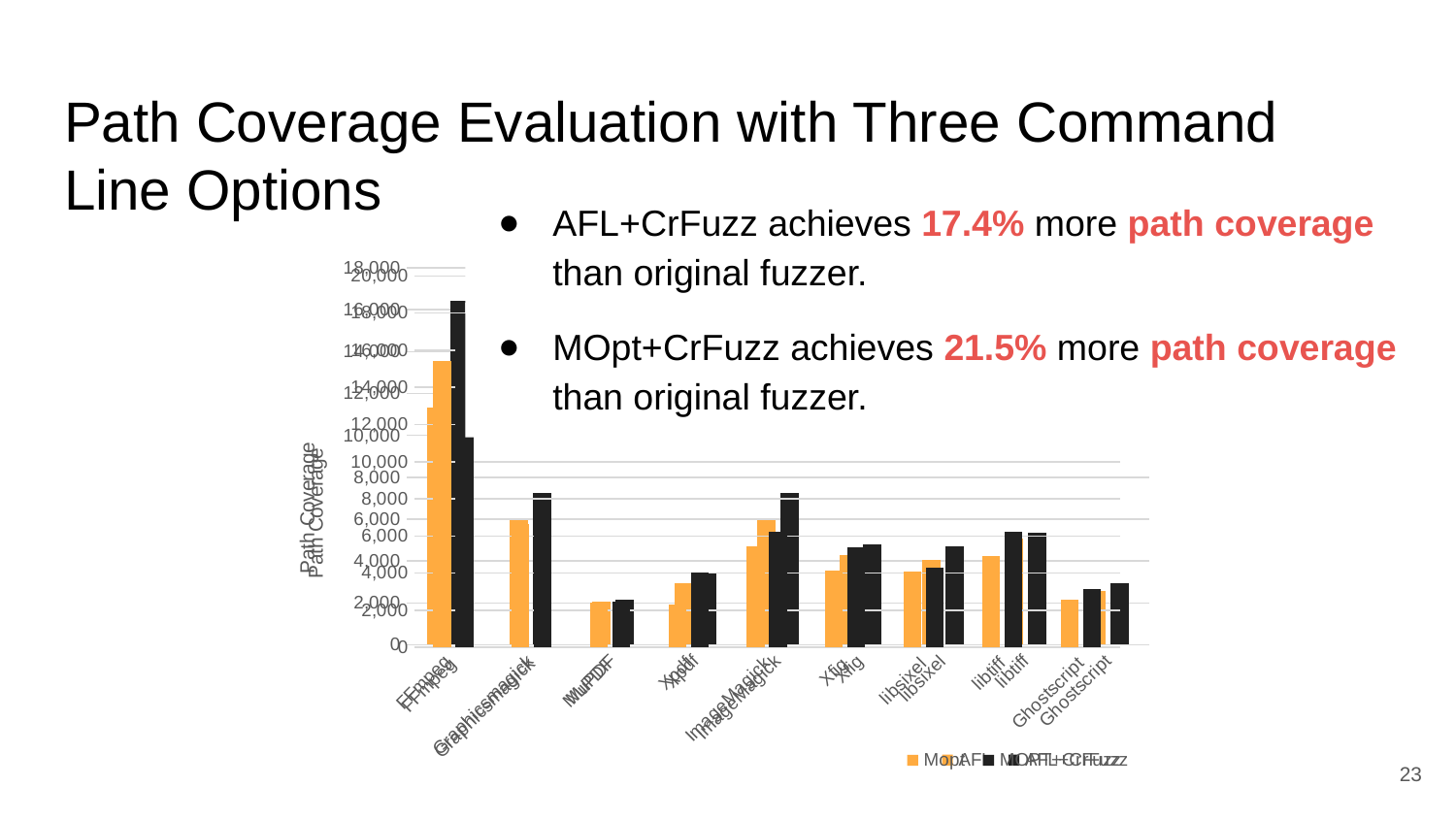
Which program has higher path coverage bars, FFmpeg or Ghostscript? FFmpeg Is the tallest bar for FFmpeg greater or less than 10,000? greater How many programs (categories) are shown along the x axis of the chart? 9 Are the bars for MuPDF greater or less than 4,000? less What is the label on the vertical axis of the chart? Path Coverage Are the bars for Xpdf greater or less than 6,000? less Which program has higher path coverage bars, ImageMagick or MuPDF? ImageMagick What two colours are used for the bars in the chart? orange and black Which program has the highest path coverage bars in the chart? FFmpeg What kind of chart is shown on the slide? bar chart